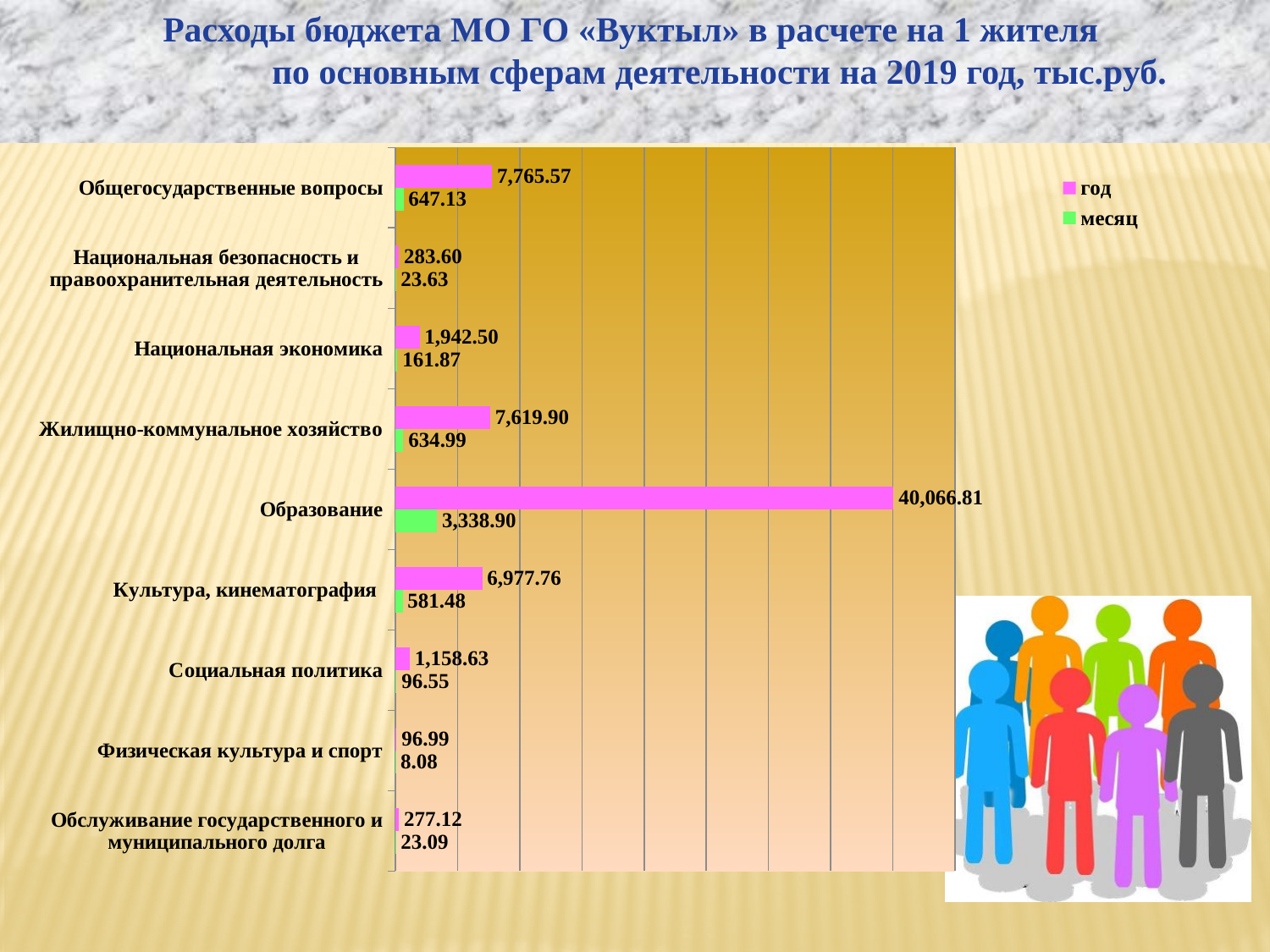
What is the value of the "год" series for "Культура, кинематография"? 6,977.76 Which is larger in the "год" series: "Национальная экономика" or "Социальная политика"? Национальная экономика How many categories are shown on the chart? 9 What is the value of the "месяц" series for "Жилищно-коммунальное хозяйство"? 634.99 Which category has the lowest value in the "месяц" series? Физическая культура и спорт What is the value of the "год" series for "Образование"? 40,066.81 What is the difference between the "год" values for "Общегосударственные вопросы" and "Жилищно-коммунальное хозяйство"? 145.67 How many series does the legend list? 2 Which series is shown in green in the legend? месяц What is the value of the "месяц" series for "Физическая культура и спорт"? 8.08 Which category has the highest value in the "год" series? Образование What kind of chart is shown on the slide? Bar chart